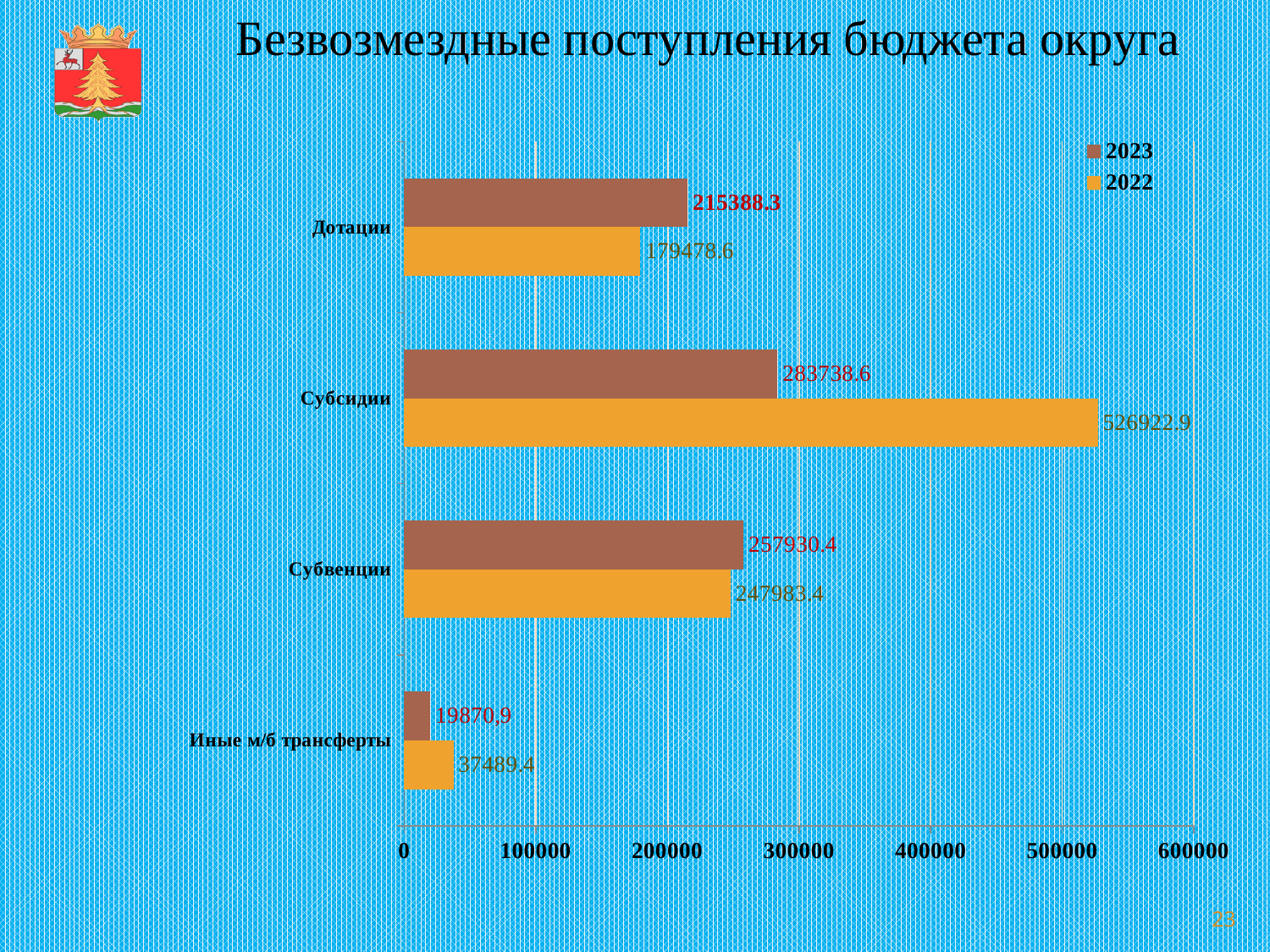
What is the difference between the 2022 and 2023 values for Субсидии? 243184.3 How many categories are shown on the chart? 4 What type of chart is shown on the slide? Bar chart For Субвенции, which series has the larger value, 2023 or 2022? 2023 Which category has the lowest value in the 2023 series? Иные м/б трансферты What is the difference between the 2023 and 2022 values for Дотации? 35909.7 What is the value for Субсидии in the 2022 series? 526922.9 What is the value for Дотации in the 2023 series? 215388.3 What is the value for Иные м/б трансферты in the 2023 series? 19870,9 Which category has the highest value in the 2022 series? Субсидии How many series does the legend list? 2 What is the value for Субвенции in the 2022 series? 247983.4